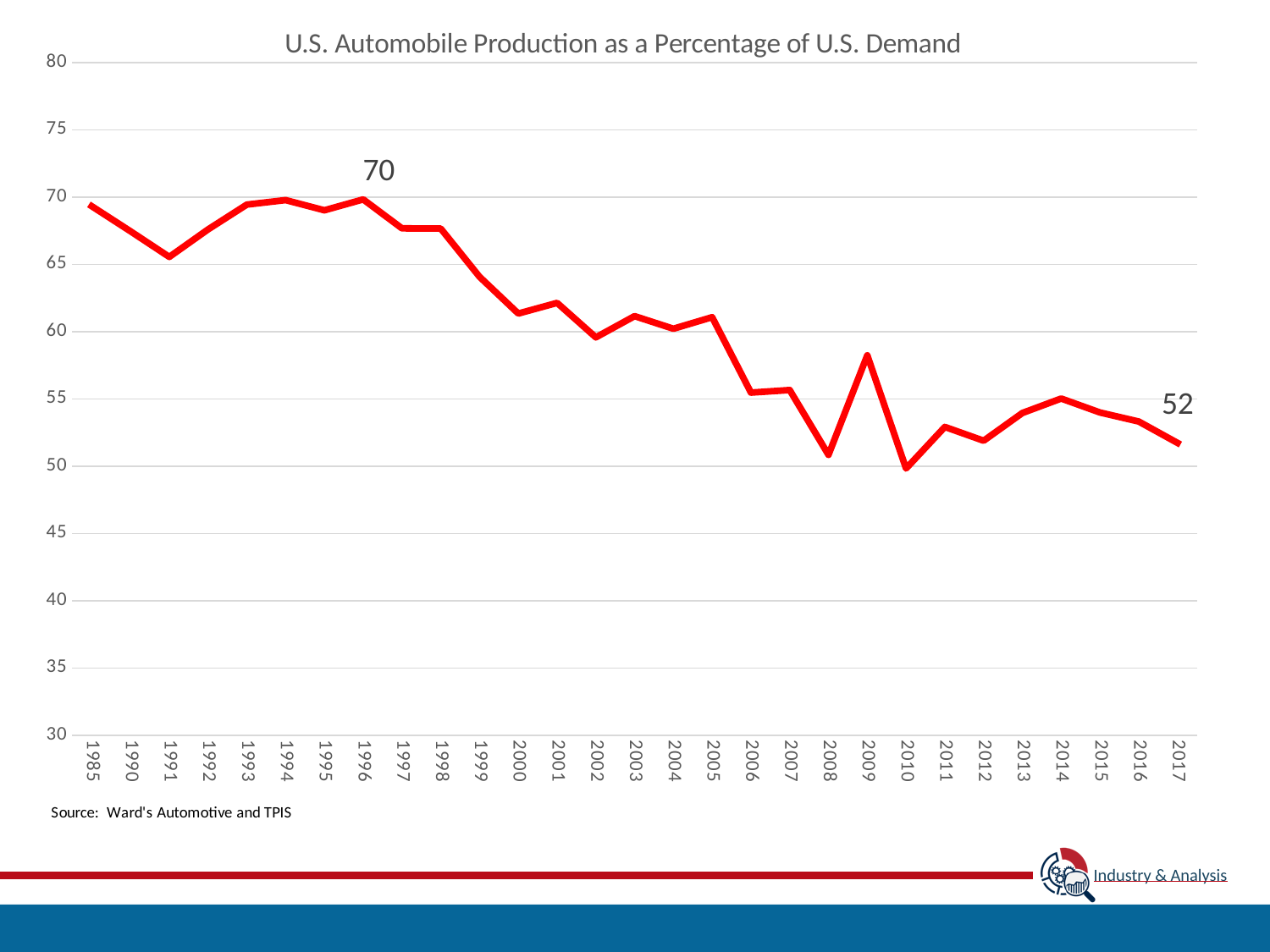
How many years are plotted on the x axis? 29 Is the value for 2009 greater or less than 55? greater What is the title of the chart? U.S. Automobile Production as a Percentage of U.S. Demand What is the value for 2017? 52 Do the values generally rise or fall from 1985 to 2017? fall Is the value for 1997 greater or less than 65? greater What is the value for 1996? 70 Which is larger, the value for 1996 or the value for 2017? 1996 Is the value for 2000 greater or less than 60? greater What kind of chart is shown on the slide? line chart What is the difference between the values for 1996 and 2017? 18